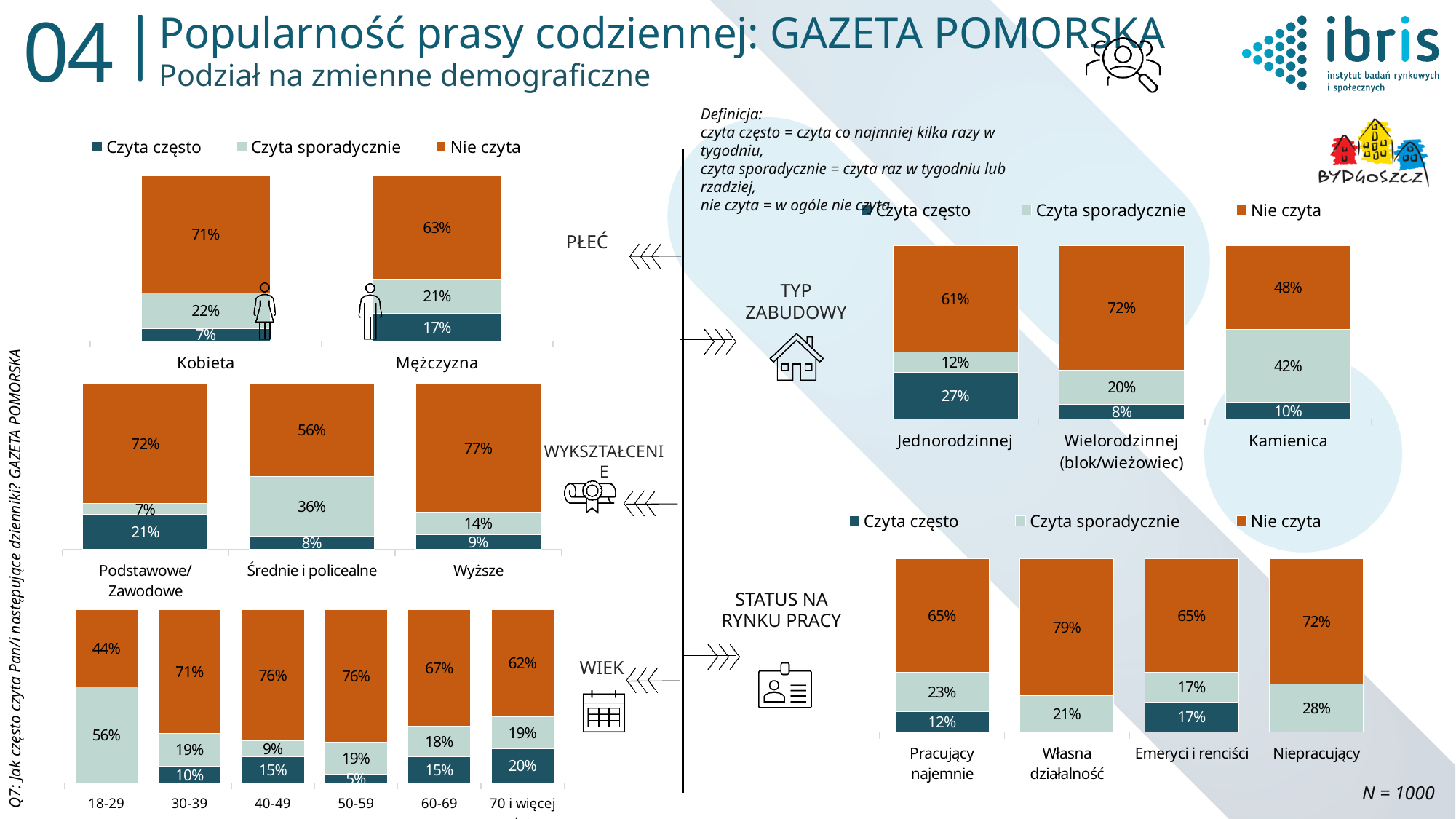
What type of chart is the TYP ZABUDOWY chart? Stacked bar chart In the TYP ZABUDOWY chart, which category has the lowest 'Nie czyta' value? Kamienica In the WYKSZTAŁCENIE chart, which category has the highest 'Nie czyta' value? Wyższe In the WIEK chart, which age group has the highest 'Czyta sporadycznie' value? 18-29 In the TYP ZABUDOWY chart, what is the 'Czyta często' value for Jednorodzinnej? 27% In the PŁEĆ chart, which has the larger 'Czyta często' value, Kobieta or Mężczyzna? Mężczyzna How many series does the legend of the PŁEĆ chart list? 3 In the STATUS NA RYNKU PRACY chart, what is the difference between the 'Nie czyta' values for Własna działalność and Pracujący najemnie? 14 percentage points In the PŁEĆ chart, what is the 'Nie czyta' value for Kobieta? 71% In the WYKSZTAŁCENIE chart, what is the 'Czyta sporadycznie' value for Średnie i policealne? 36% How many categories are shown in the STATUS NA RYNKU PRACY chart? 4 How many age groups are shown in the WIEK chart? 6